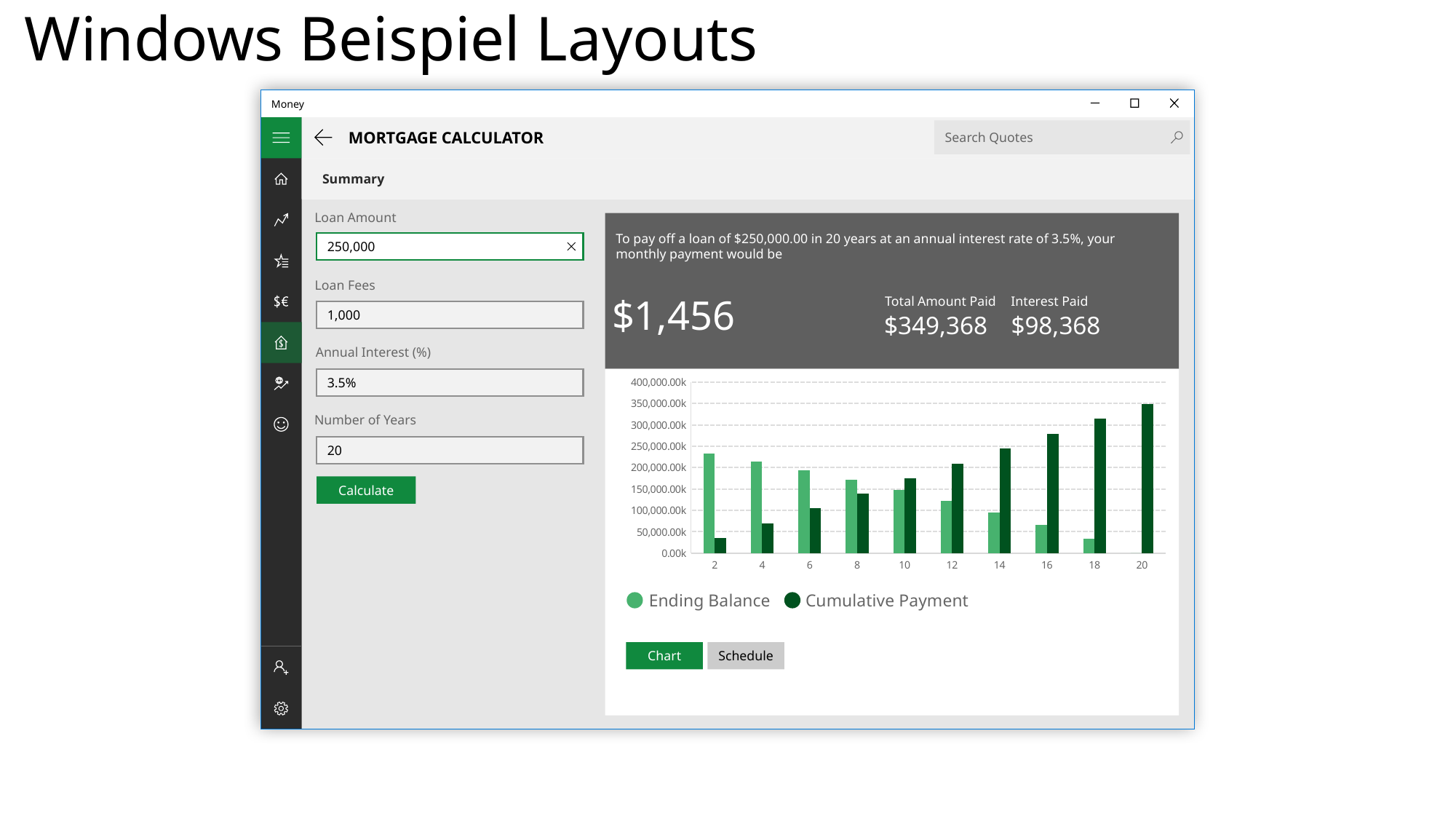
What are the two entries in the chart legend? Ending Balance and Cumulative Payment How many series does the chart legend list? 2 At which year is the Cumulative Payment highest? 20 Is the Cumulative Payment value at year 20 greater or less than 300,000.00k? greater At year 20, which is larger: Ending Balance or Cumulative Payment? Cumulative Payment At year 2, which is larger: Ending Balance or Cumulative Payment? Ending Balance At which year is the Ending Balance highest? 2 Do the Cumulative Payment values rise or fall as the years increase along the x axis? rise What kind of chart is shown in the mortgage calculator? bar chart How many year categories are shown on the x axis of the chart? 10 Is the Ending Balance value at year 2 greater or less than 200,000.00k? greater Do the Ending Balance values rise or fall as the years increase along the x axis? fall